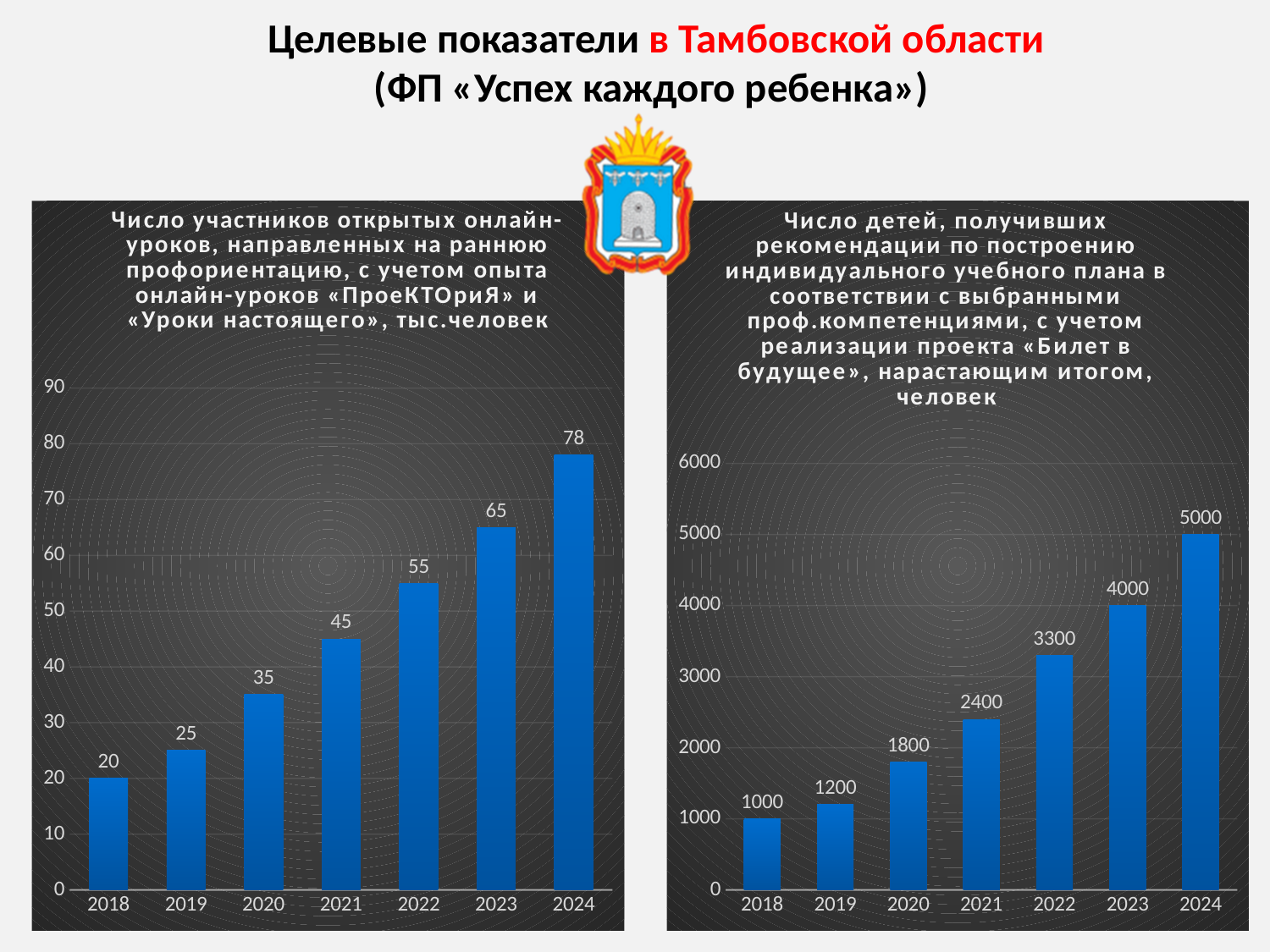
In the right chart, do the values rise or fall from 2018 to 2024? rise In the left chart, what is the value for 2018? 20 In the left chart, which year has the highest value? 2024 In the right chart, which is larger: the value for 2019 or the value for 2020? 2020 How many years are shown on the x axis of the left chart? 7 In the right chart, which year has the lowest value? 2018 What kind of chart is the right chart? bar chart In the left chart (number of participants in open online lessons, thousand people), what is the value for 2021? 45 In the right chart (number of children who received recommendations on an individual study plan), what is the value for 2022? 3300 In the right chart, what is the difference between the values for 2021 and 2020? 600 In the left chart, what is the difference between the values for 2024 and 2023? 13 In the left chart, is the value for 2022 greater or less than 50? greater